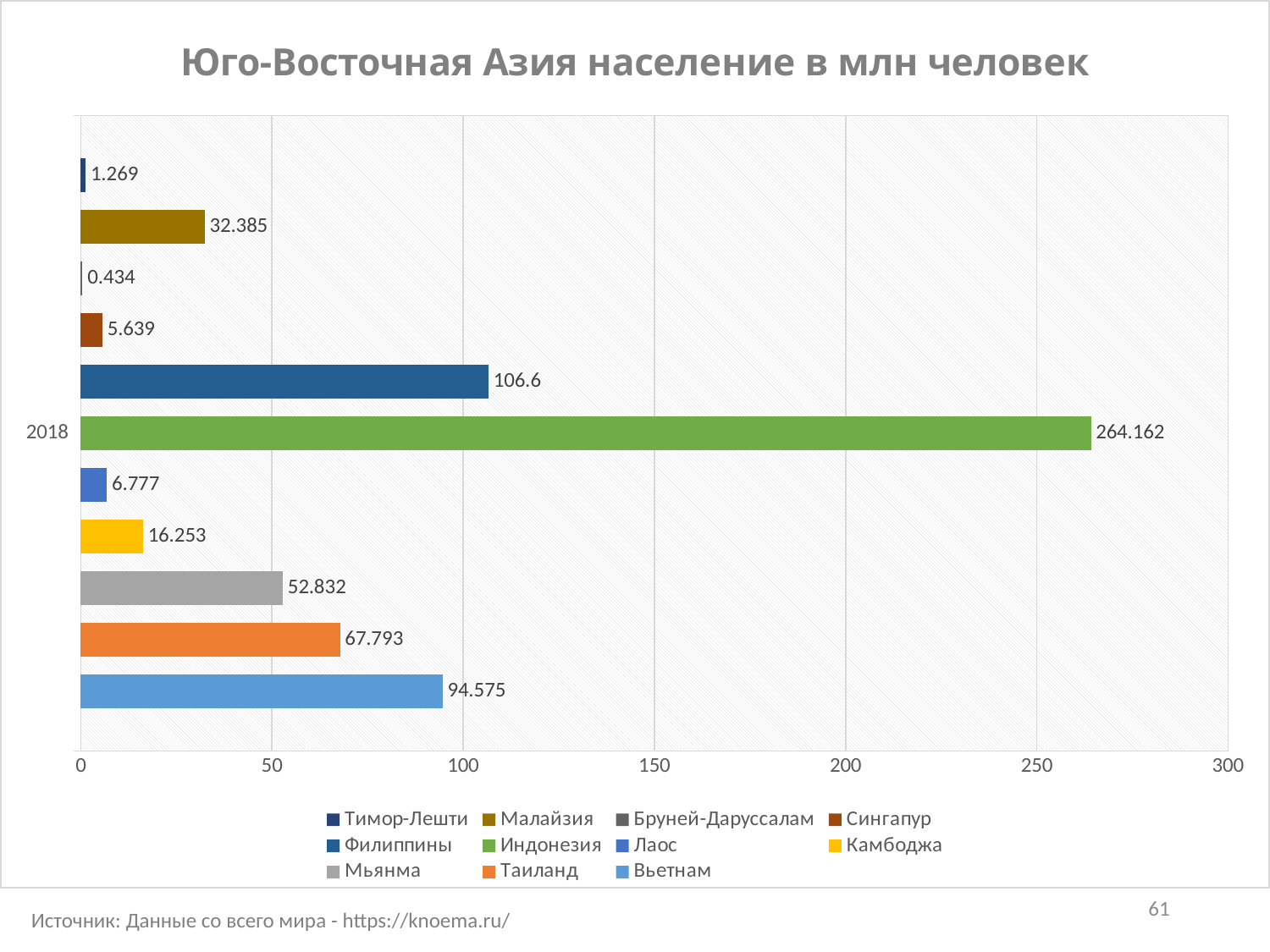
How many series does the legend list? 11 What is the difference between the values for Филиппины and Вьетнам? 12.025 What kind of chart is shown on the slide? Bar chart What is the population value shown for Вьетнам? 94.575 Which has a larger value, Малайзия or Камбоджа? Малайзия Is the value for Мьянма greater or less than 50? greater What is the population value shown for Индонезия? 264.162 What is the title of the chart? Юго-Восточная Азия население в млн человек Which country has the highest population in the chart? Индонезия Which country has the lowest population in the chart? Бруней-Даруссалам What is the population value shown for Бруней-Даруссалам? 0.434 What is the population value shown for Таиланд? 67.793